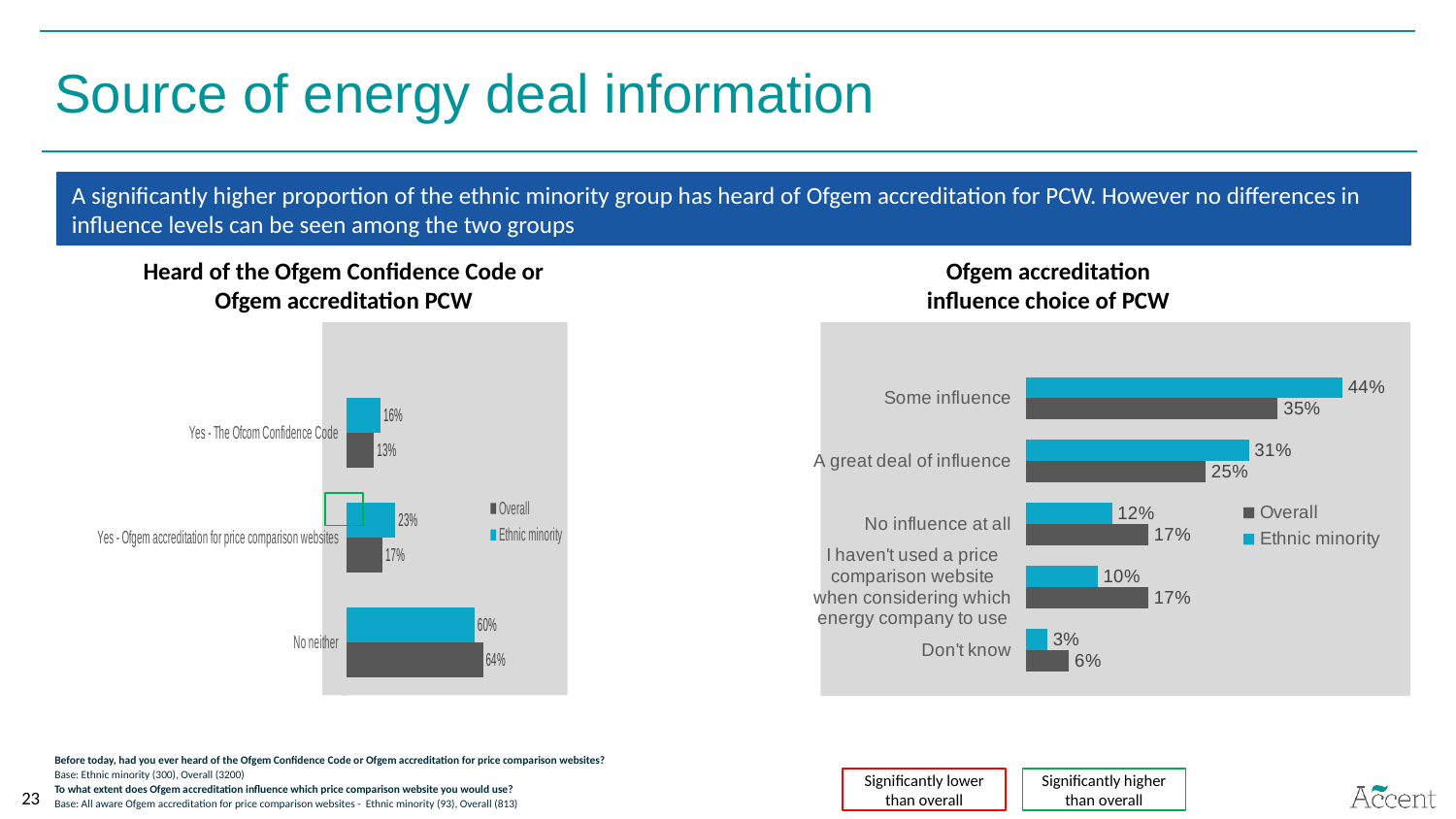
In the 'Ofgem accreditation influence choice of PCW' chart, what is the Ethnic minority value for 'Some influence'? 44% In the 'Heard of the Ofgem Confidence Code or Ofgem accreditation PCW' chart, what is the Overall value for 'No neither'? 64% In the 'Ofgem accreditation influence choice of PCW' chart, what is the Overall value for 'A great deal of influence'? 25% In the 'Ofgem accreditation influence choice of PCW' chart, which category has the highest Ethnic minority value? Some influence In the 'Ofgem accreditation influence choice of PCW' chart, what is the Overall value for 'Don't know'? 6% In the 'Ofgem accreditation influence choice of PCW' chart, which category has the lowest Overall value? Don't know In the 'Heard of the Ofgem Confidence Code or Ofgem accreditation PCW' chart, how many series does the legend list? 2 In the 'Heard of the Ofgem Confidence Code or Ofgem accreditation PCW' chart, what is the Ethnic minority value for 'Yes - Ofgem accreditation for price comparison websites'? 23% In the 'Ofgem accreditation influence choice of PCW' chart, what is the difference between the Ethnic minority and Overall values for 'No influence at all'? 5% In the 'Heard of the Ofgem Confidence Code or Ofgem accreditation PCW' chart, which is larger for 'No neither': the Overall value or the Ethnic minority value? Overall In the 'Ofgem accreditation influence choice of PCW' chart, how many categories are shown? 5 What type of chart is the 'Heard of the Ofgem Confidence Code or Ofgem accreditation PCW' chart? Bar chart